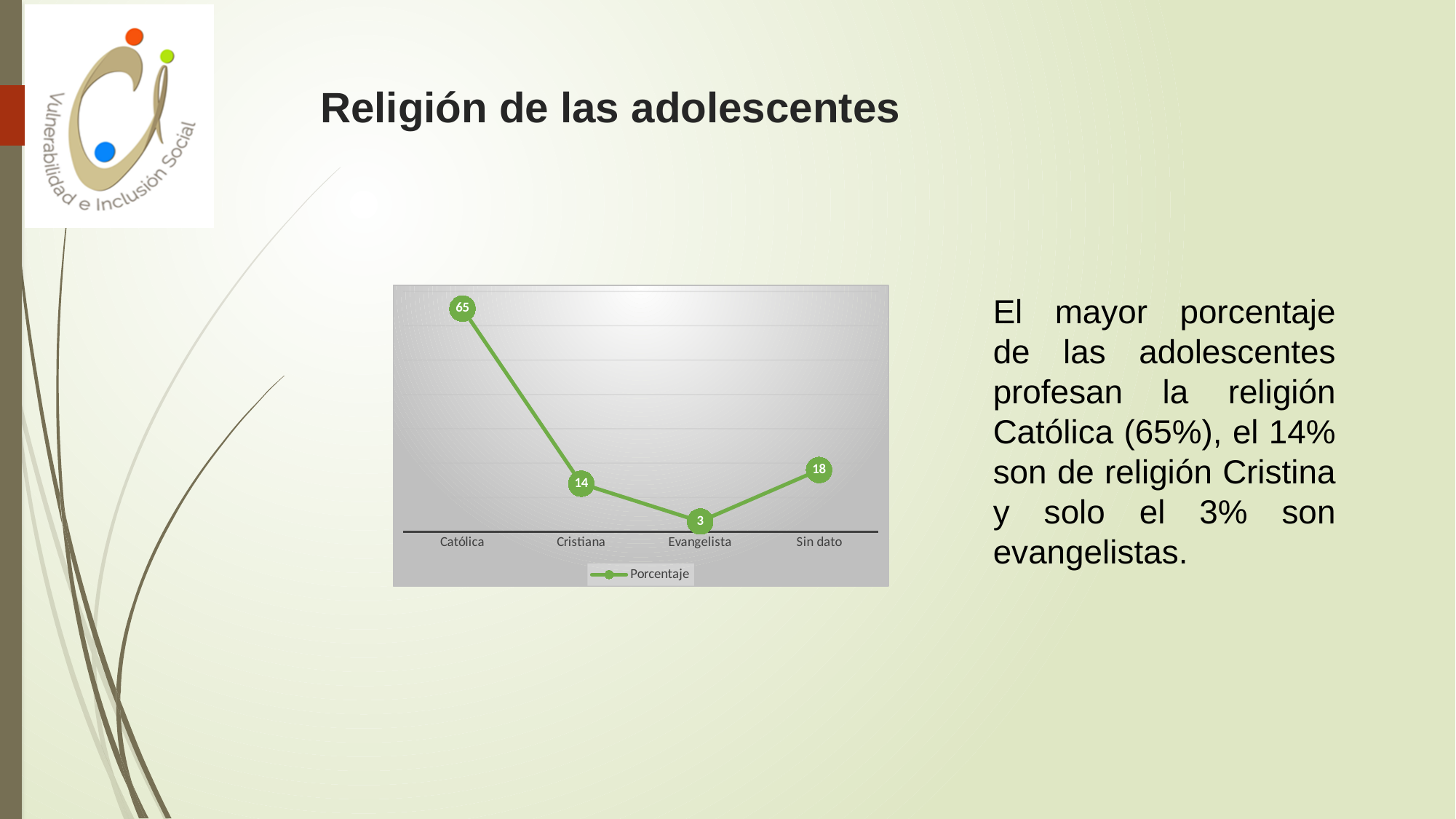
What series name does the legend show? Porcentaje What is the difference between the values for Católica and Cristiana? 51 Which category has the highest value? Católica What is the value for Evangelista? 3 Which is larger, the value for Sin dato or the value for Cristiana? Sin dato How many categories are plotted on the chart? 4 What is the value for Sin dato? 18 What is the value for Católica? 65 What is the difference between the values for Sin dato and Evangelista? 15 What kind of chart is shown on the slide? Line chart Which category has the lowest value? Evangelista What is the value for Cristiana? 14